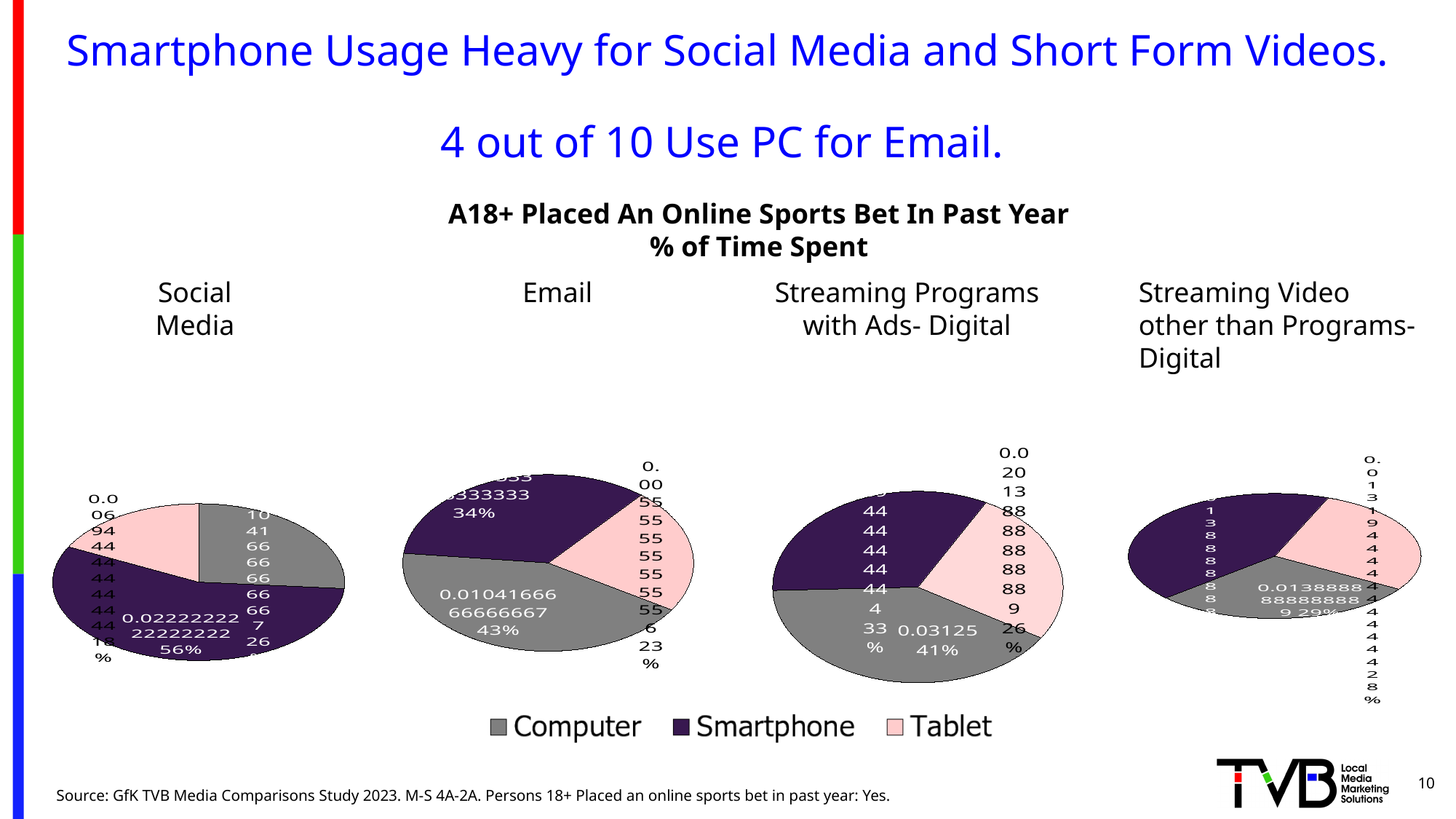
In the Social Media pie chart, what share of time spent is on Smartphone? 56% In the Social Media pie chart, which device has the largest share? Smartphone In the Streaming Programs with Ads- Digital pie chart, what share of time spent is on Tablet? 26% What kind of charts are shown on the slide? Pie charts In the Streaming Video other than Programs- Digital pie chart, which device has the largest share? Smartphone How many series does the legend list? 3 In the Streaming Programs with Ads- Digital pie chart, which device has the smallest share? Tablet How many pie charts are on the slide? 4 In the Social Media pie chart, which is larger, the Computer share or the Tablet share? Computer In the Email pie chart, what share of time spent is on Computer? 43% In the Email pie chart, which device has the largest share? Computer In the Email pie chart, how many percentage points larger is the Computer share than the Smartphone share? 9 percentage points